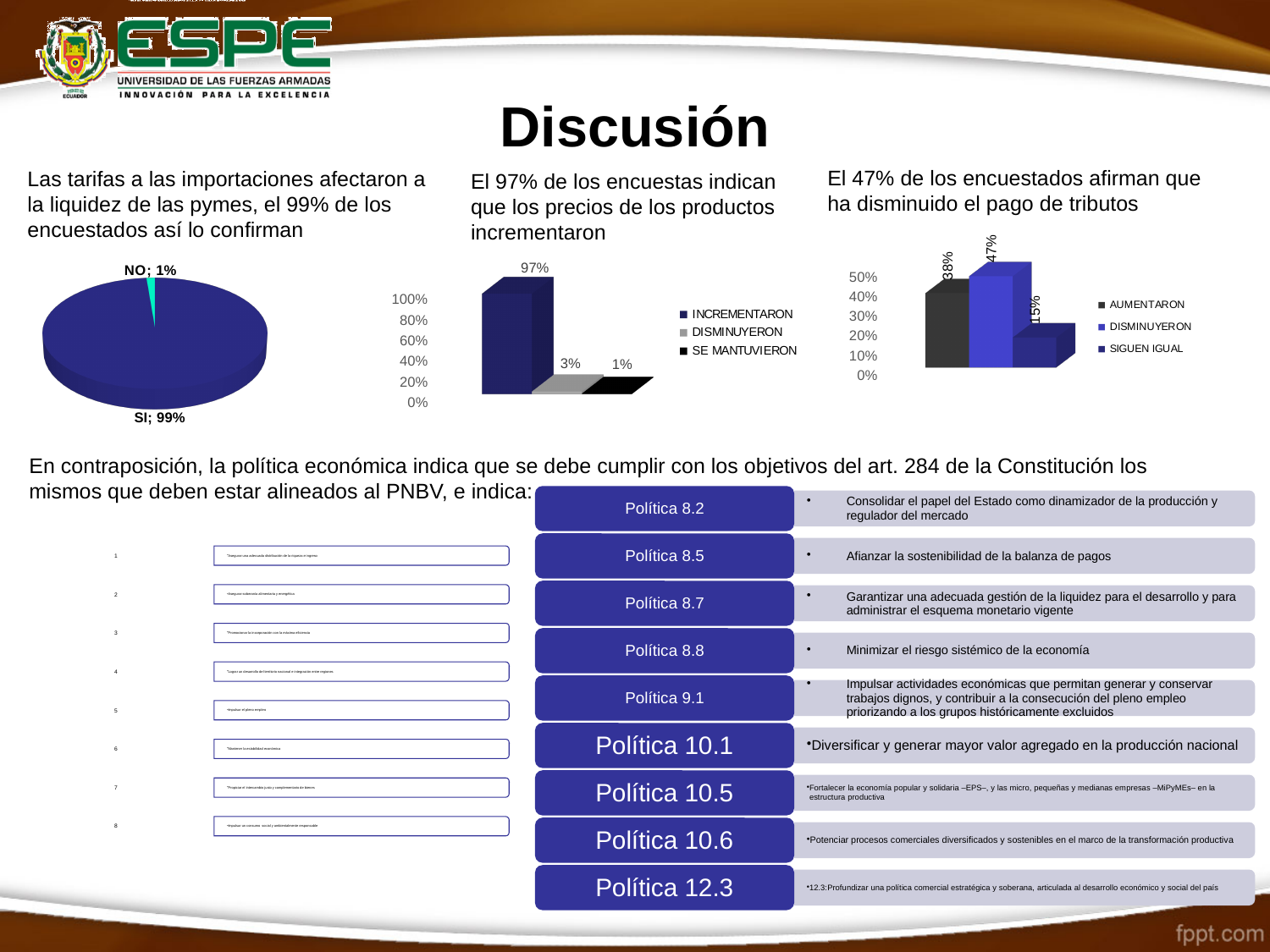
In the bar chart on the right, which category has the highest value? DISMINUYERON In the bar chart on the right, what is the difference between DISMINUYERON and SIGUEN IGUAL? 32% How many series does the legend of the middle bar chart list? 3 In the pie chart on the left, what share of respondents answered SI? 99% How many slices does the pie chart on the left have? 2 What type of chart is the chart on the left of the slide? pie chart In the middle bar chart, what is the value for DISMINUYERON? 3% In the bar chart on the right, what is the value for AUMENTARON? 38% In the pie chart on the left, what share of respondents answered NO? 1% In the middle bar chart, which category has the lowest value? SE MANTUVIERON In the middle bar chart, what is the value for INCREMENTARON? 97% In the middle bar chart, what is the difference between INCREMENTARON and DISMINUYERON? 94%